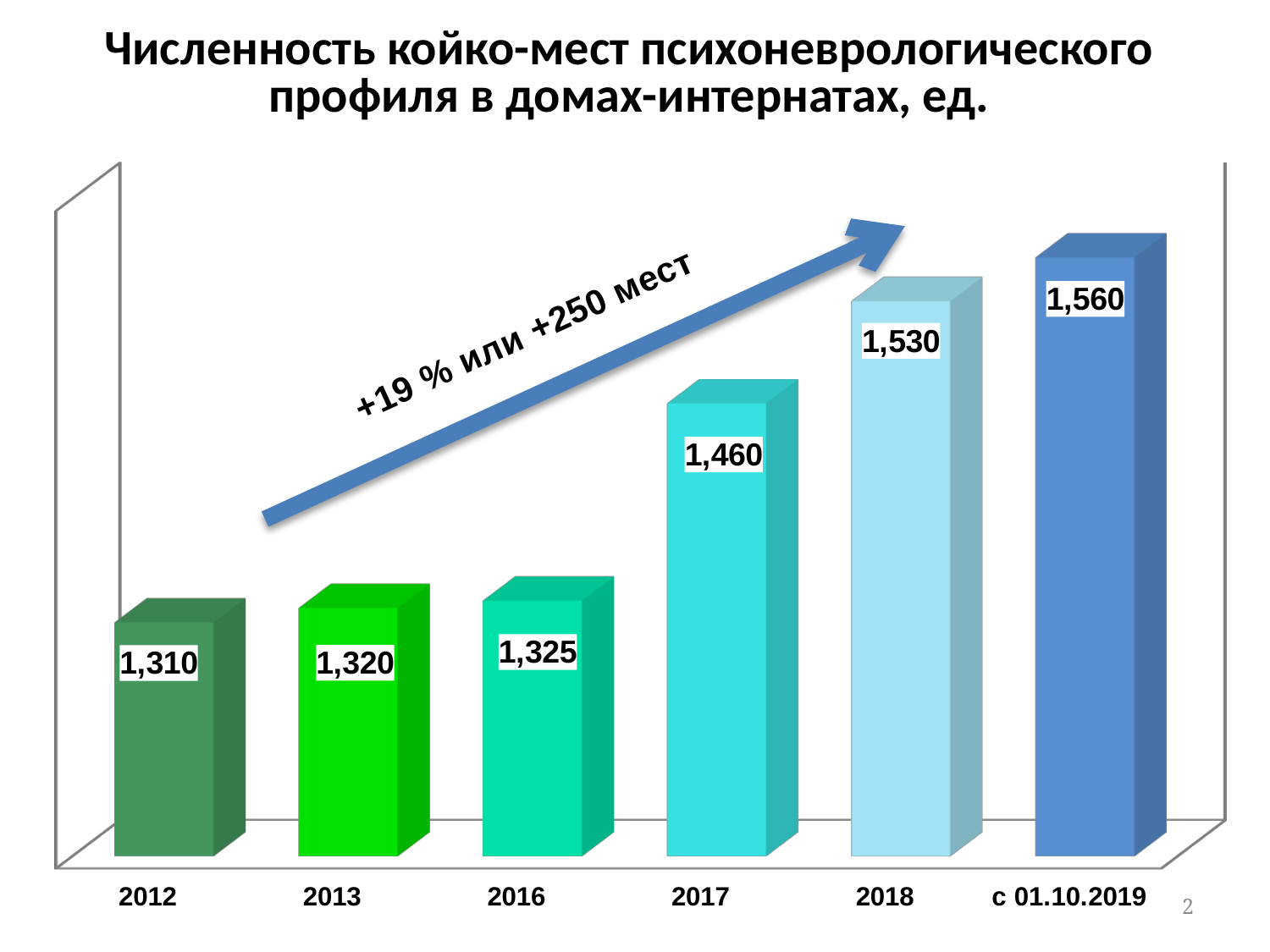
What is the difference between the values for с 01.10.2019 and 2012? 250 What does the text along the arrow on the chart say? +19 % или +250 мест What kind of chart is shown on the slide? bar chart Which is larger, the value for 2016 or the value for 2017? 2017 What is the value for с 01.10.2019? 1,560 What is the value for 2012? 1,310 What is the value for 2017? 1,460 Which category has the lowest value? 2012 What is the difference between the values for 2018 and 2017? 70 How many categories are shown on the x axis? 6 Do the values rise or fall along the x axis? rise Which category has the highest value? с 01.10.2019